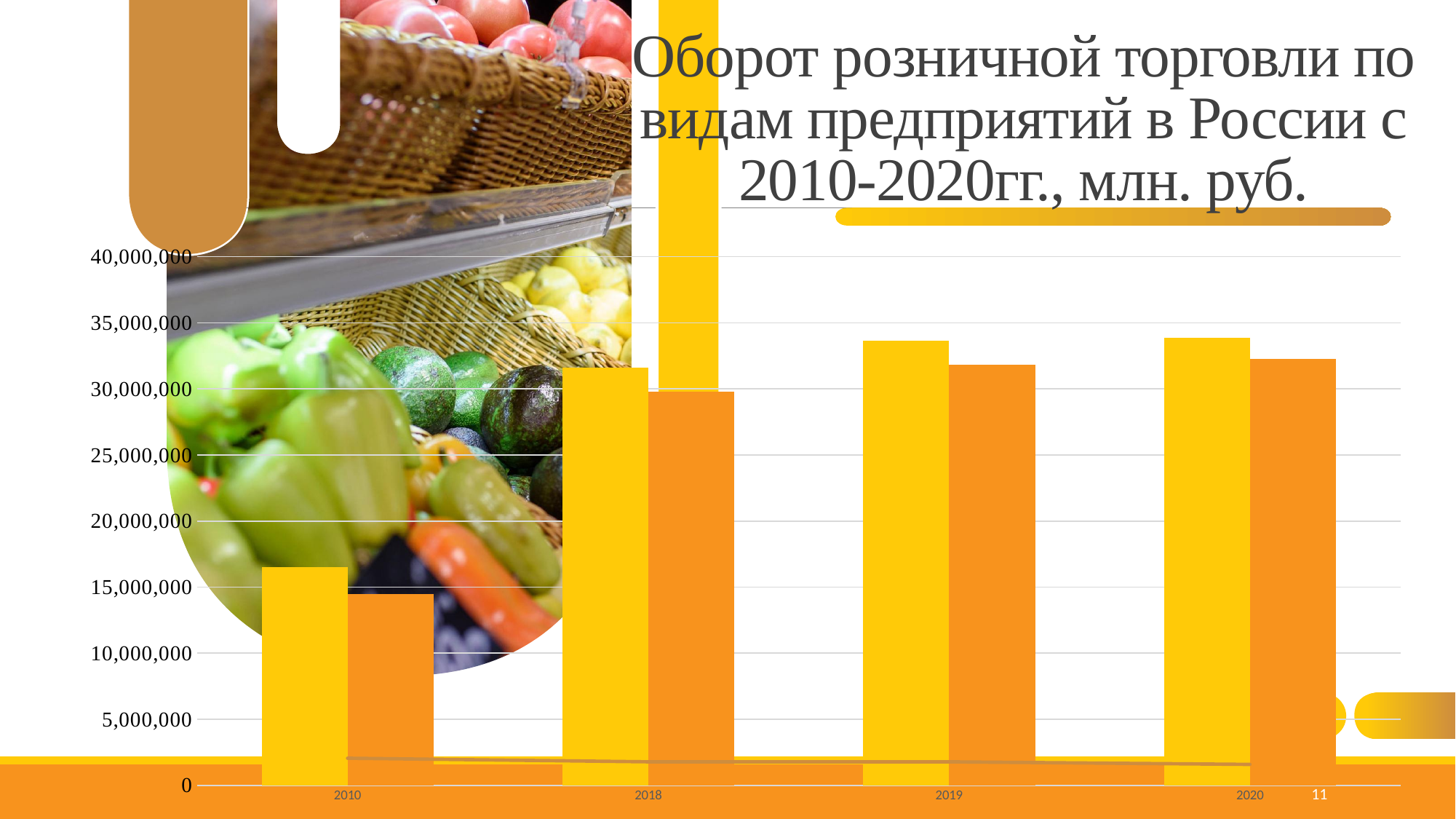
Is the value of the yellow bar for 2010 greater or less than 15,000,000? greater Is the value of the yellow bar for 2020 greater or less than 35,000,000? less In which year is the yellow bar the lowest? 2010 Is the value of the orange bar for 2010 greater or less than 15,000,000? less What kind of chart is shown on the slide? combination bar and line chart How many years are shown on the x axis of the chart? 4 Which years are shown on the x axis of the chart? 2010, 2018, 2019, 2020 For 2010, which bar is larger, the yellow one or the orange one? the yellow one Do the yellow bars rise or fall from 2010 to 2020? rise What is the title of the chart on the slide? Оборот розничной торговли по видам предприятий в России с 2010-2020гг., млн. руб.